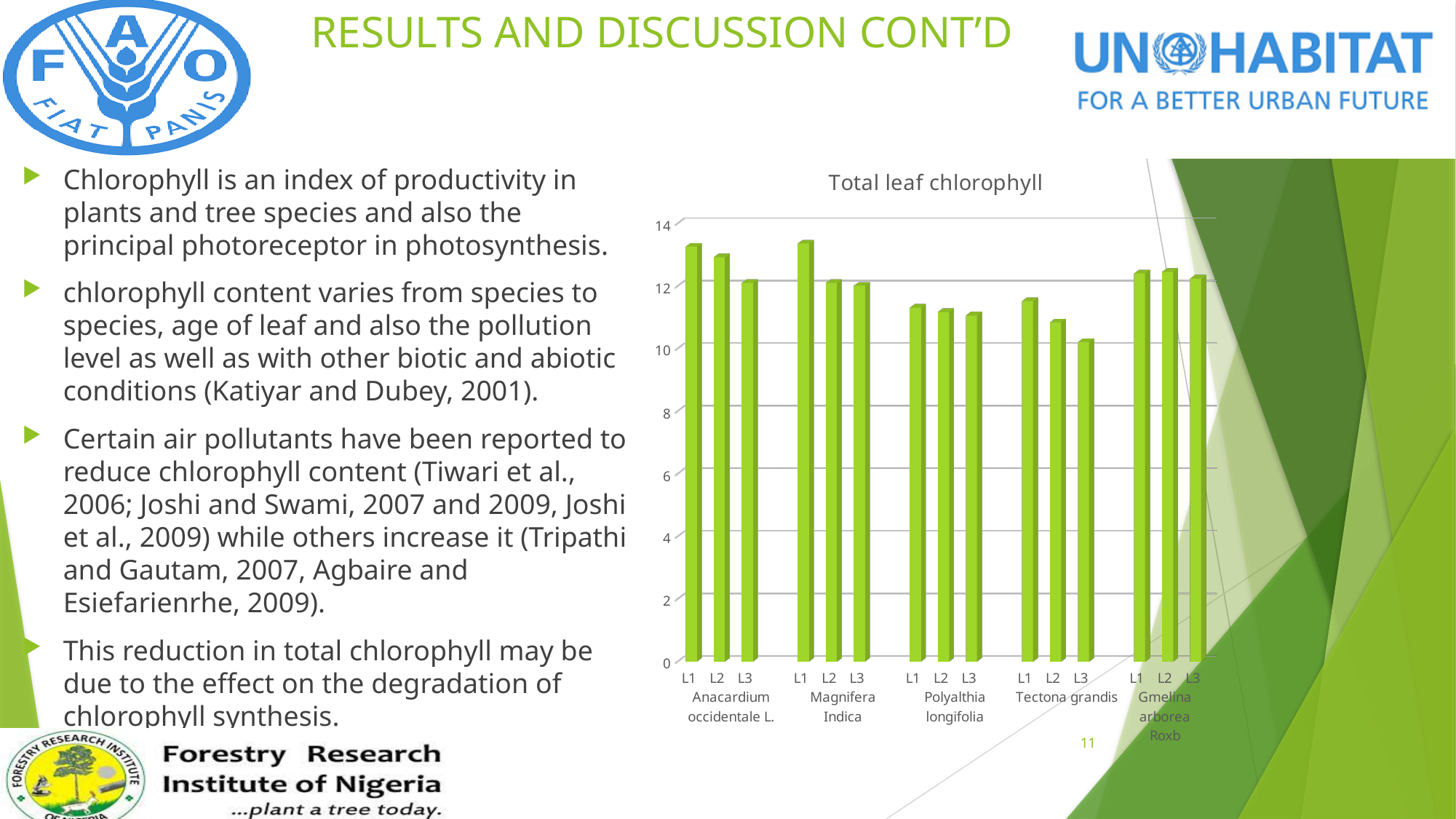
What is the title of the chart? Total leaf chlorophyll Which bar has the lowest value in the chart? Tectona grandis L3 Is the value for Magnifera Indica L1 greater or less than 14? less Which is larger, the value for Tectona grandis L1 or Gmelina arborea Roxb L1? Gmelina arborea Roxb L1 Is the value for Anacardium occidentale L. L1 greater or less than 12? greater What is the highest value shown on the vertical axis of the chart? 14 Do the values for Tectona grandis rise or fall from L1 to L3? fall How many tree species are shown along the x axis of the chart? 5 Is the value for Tectona grandis L3 greater or less than 12? less What kind of chart is shown on the slide? bar chart How many bars are plotted in the chart in total? 15